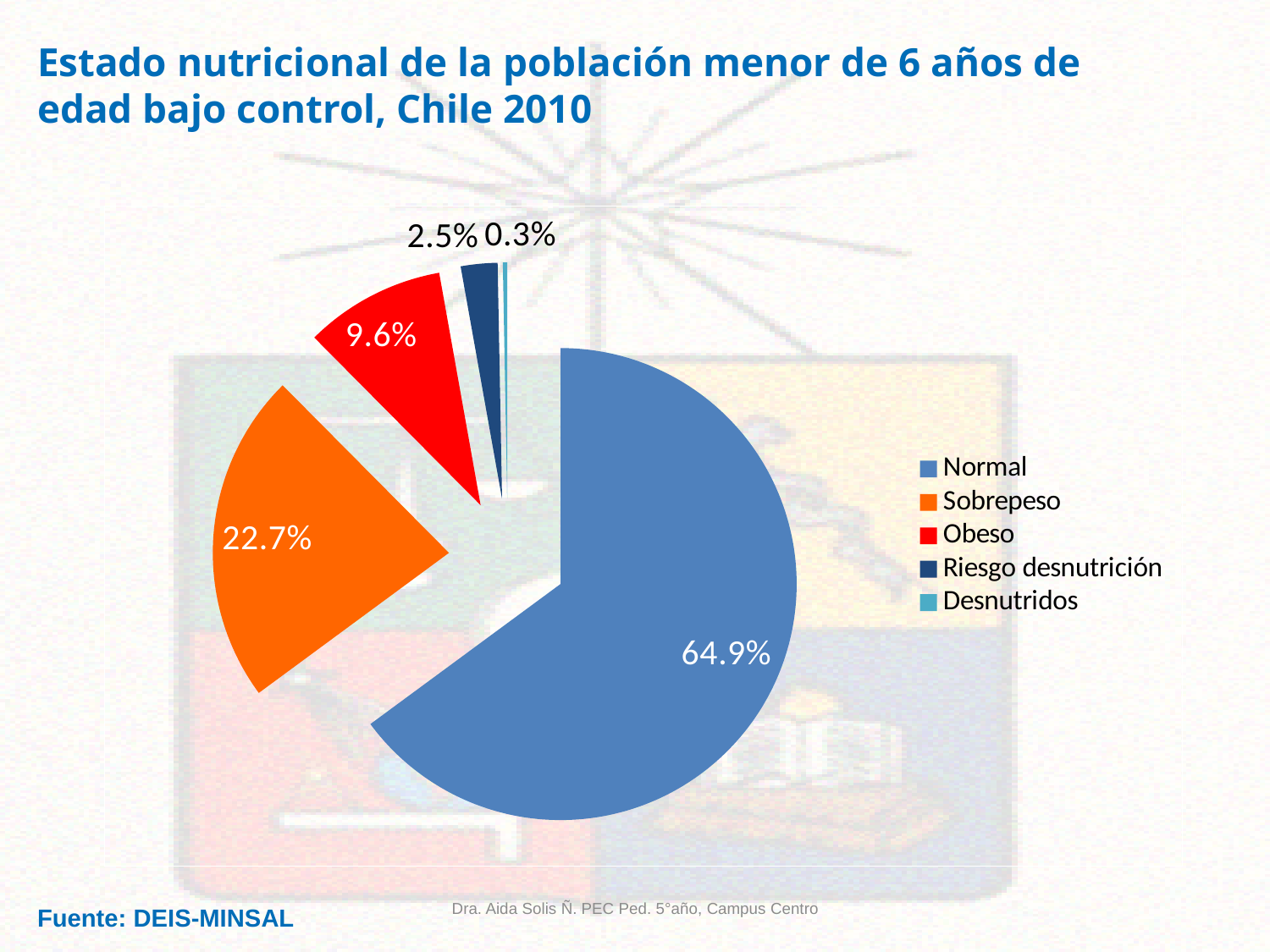
Which category has the largest share of the pie? Normal What is the difference in percentage points between Sobrepeso and Obeso? 13.1 What percentage of the population is labelled Obeso? 9.6% What percentage of the population is labelled Normal? 64.9% Which is larger, the share for Obeso or the share for Riesgo desnutrición? Obeso What percentage of the population is labelled Sobrepeso? 22.7% What percentage of the population is labelled Desnutridos? 0.3% What colour is the Sobrepeso slice? Orange How many categories does the legend list? 5 What kind of chart is shown on the slide? Pie chart Which category has the smallest share of the pie? Desnutridos What percentage of the population is labelled Riesgo desnutrición? 2.5%